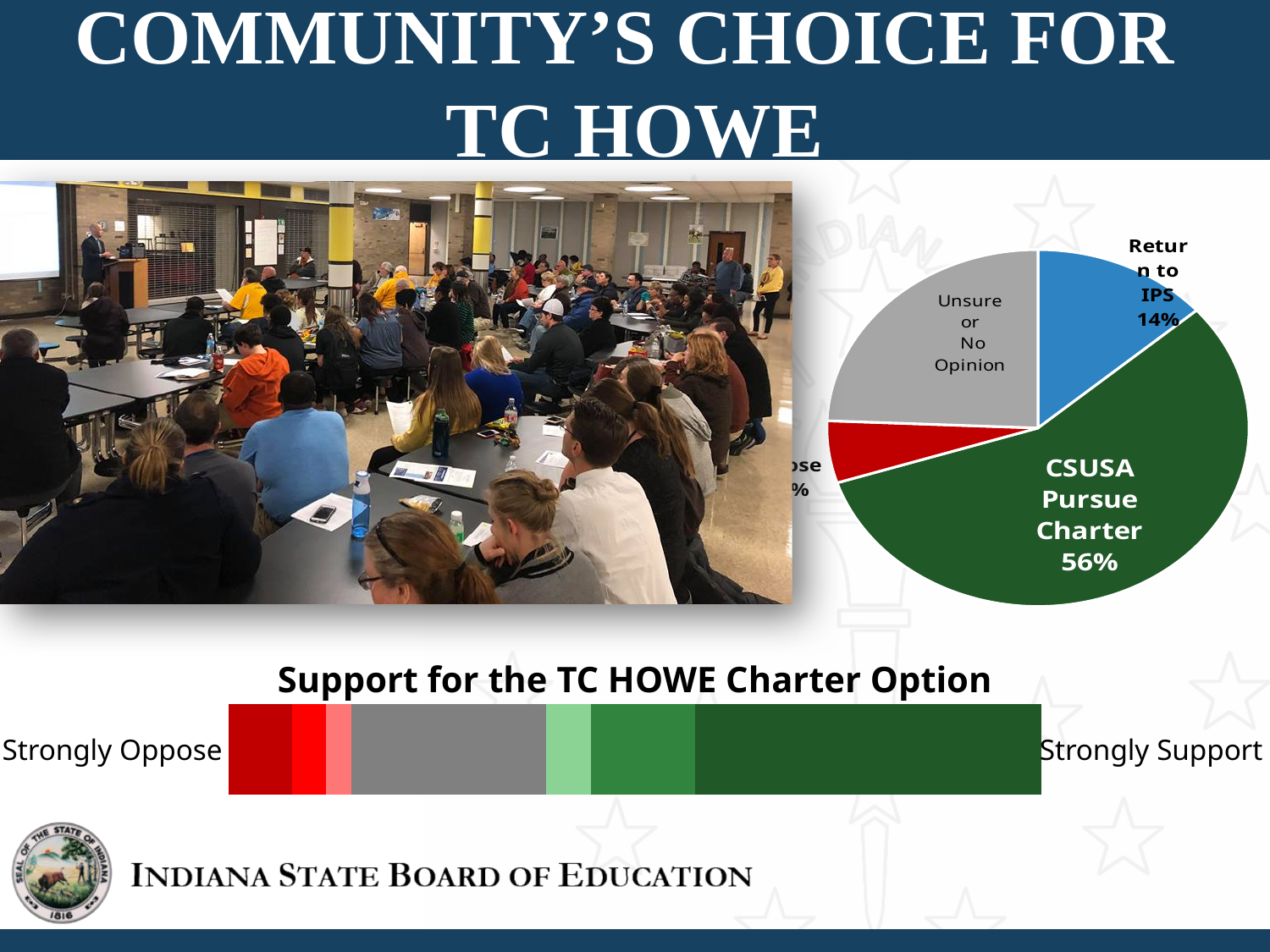
What kind of chart is the chart titled 'Support for the TC HOWE Charter Option'? bar chart In the pie chart, which option has the largest slice? CSUSA Pursue Charter What is the title of the horizontal bar chart at the bottom of the slide? Support for the TC HOWE Charter Option In the pie chart, which is larger: the CSUSA Pursue Charter slice or the Return to IPS slice? CSUSA Pursue Charter In the pie chart, how many percentage points larger is the CSUSA Pursue Charter slice than the Return to IPS slice? 42 percentage points In the pie chart, what share of respondents chose Return to IPS? 14% In the chart titled 'Support for the TC HOWE Charter Option', what label appears at the right end of the bar? Strongly Support In the pie chart, what share of respondents chose CSUSA Pursue Charter? 56% In the pie chart, which is larger: the Unsure or No Opinion slice or the Return to IPS slice? Unsure or No Opinion How many slices does the pie chart have? 4 In the pie chart, is the Unsure or No Opinion slice greater or less than 50%? less What kind of chart is the chart in the upper right of the slide? pie chart